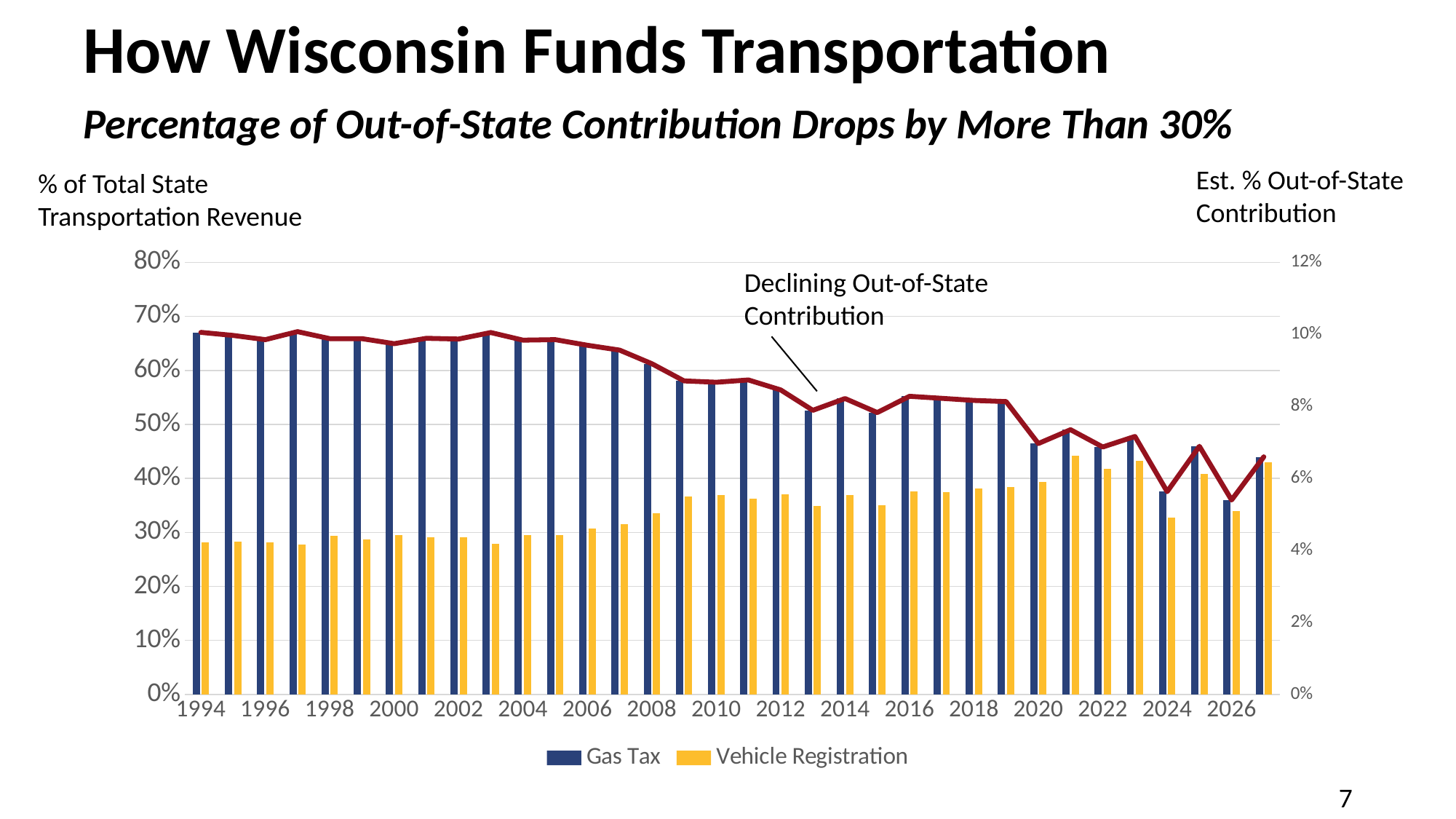
Is the Vehicle Registration value for 2008 greater or less than 30%? greater Which two series are listed in the legend? Gas Tax and Vehicle Registration How many series does the legend list? 2 What is the subtitle of the chart on the slide? Percentage of Out-of-State Contribution Drops by More Than 30% Does the estimated out-of-state contribution line rise or fall from 1994 to 2026? Fall Is the Gas Tax value for 1994 greater or less than 60%? greater What kind of chart is shown on the slide? Bar chart with a line In 2024, which is larger: Gas Tax or Vehicle Registration? Gas Tax Does the Gas Tax share of total state transportation revenue rise or fall from 1994 to 2026? Fall Is the Vehicle Registration value for 2021 greater or less than 40%? greater In 1994, which is larger: Gas Tax or Vehicle Registration? Gas Tax